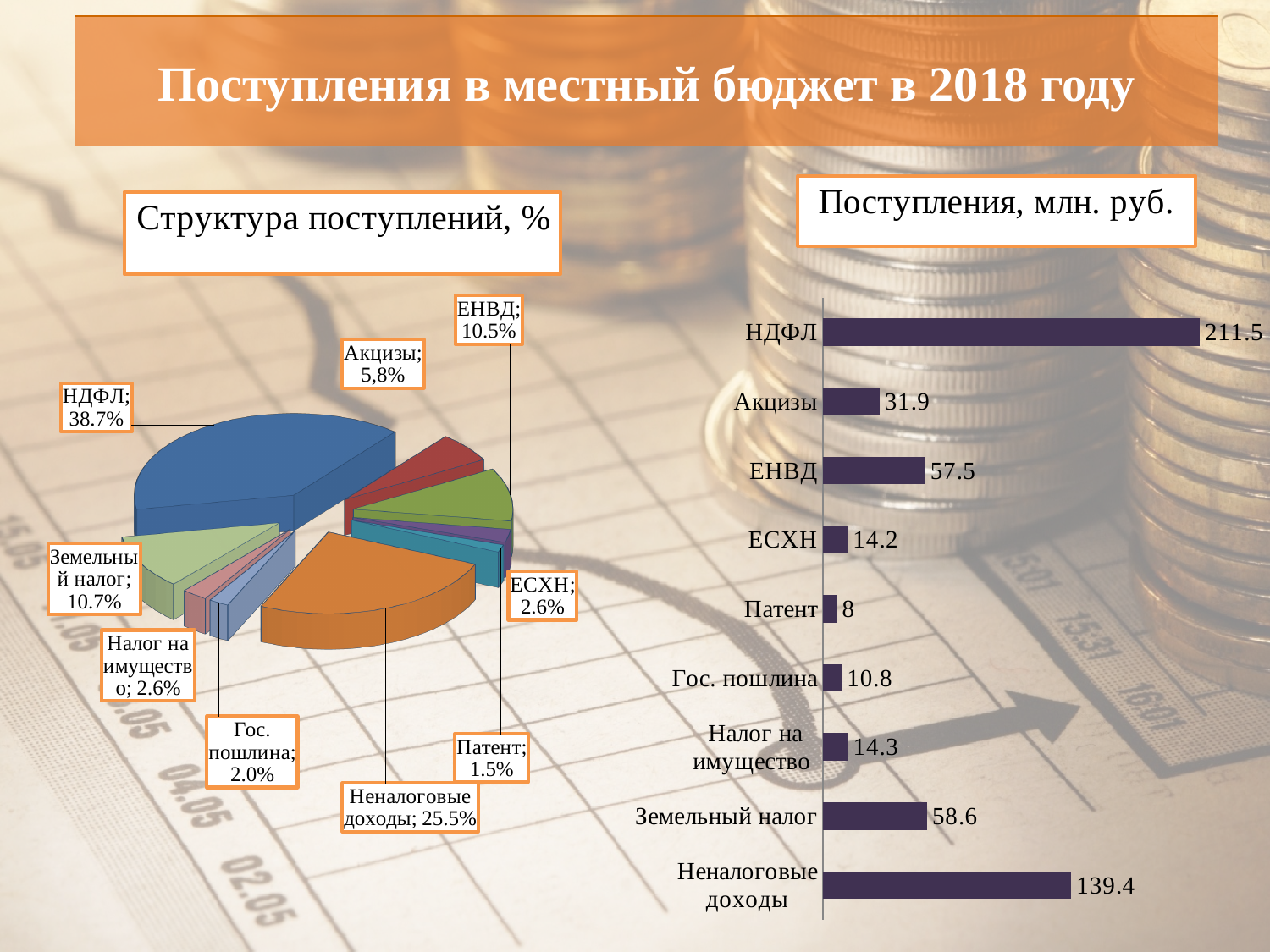
In the pie chart 'Структура поступлений, %', which category has the smallest share? Патент In the bar chart 'Поступления, млн. руб.', what is the difference between Земельный налог and ЕНВД? 1.1 In the bar chart 'Поступления, млн. руб.', which is larger: Акцизы or ЕСХН? Акцизы In the bar chart 'Поступления, млн. руб.', which category has the lowest value? Патент What type of chart is 'Структура поступлений, %'? pie chart How many categories are shown in the bar chart 'Поступления, млн. руб.'? 9 In the pie chart 'Структура поступлений, %', what is the value for Неналоговые доходы? 25.5% In the bar chart 'Поступления, млн. руб.', what is the value for НДФЛ? 211.5 In the bar chart 'Поступления, млн. руб.', which category has the highest value? НДФЛ In the pie chart 'Структура поступлений, %', what share does НДФЛ have? 38.7% What type of chart is 'Поступления, млн. руб.'? bar chart In the bar chart 'Поступления, млн. руб.', what is the value for Неналоговые доходы? 139.4